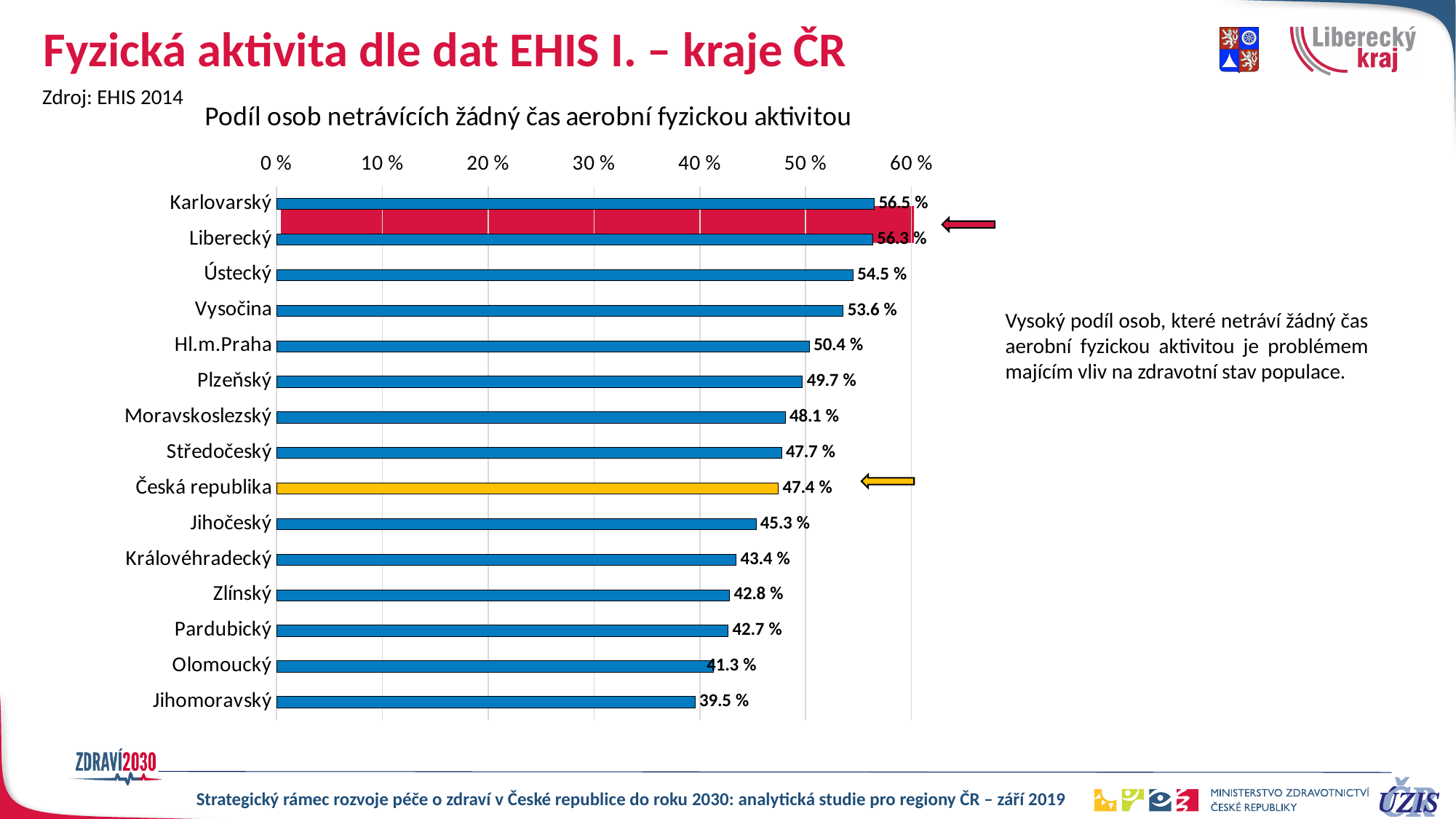
Which region has the highest value? Karlovarský What is the value for Ústecký? 54.5 % What is the value for Hl.m.Praha? 50.4 % What is the value for Česká republika? 47.4 % What is the value for Jihomoravský? 39.5 % What is the title of the chart? Podíl osob netrávících žádný čas aerobní fyzickou aktivitou How many bars are shown in the chart? 15 Which region has the lowest value? Jihomoravský What is the difference between the values for Liberecký and Česká republika? 8.9 % What is the difference between the values for Karlovarský and Jihomoravský? 17.0 % What type of chart is shown on the slide? Bar chart Which has a larger value, Vysočina or Plzeňský? Vysočina